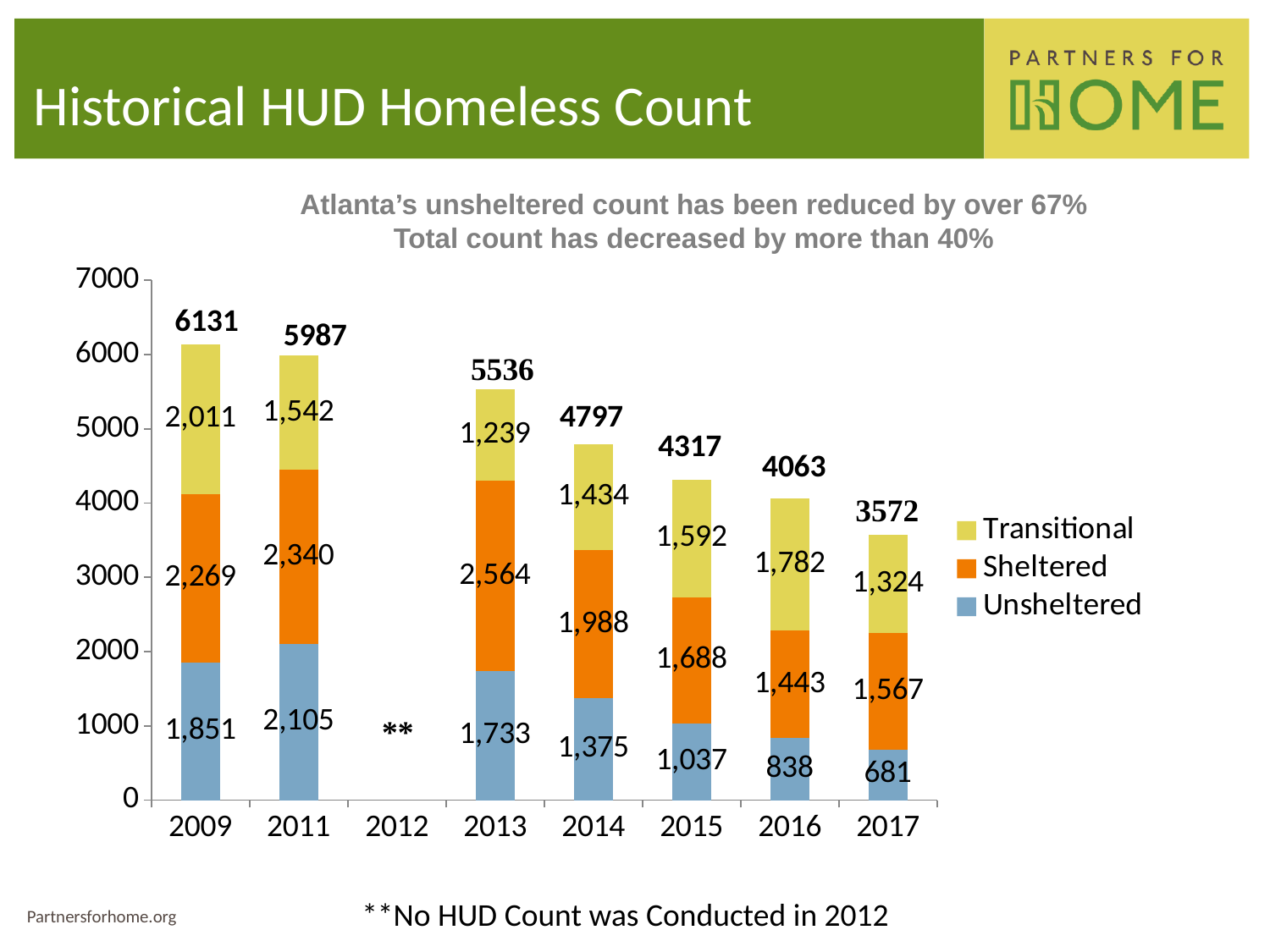
Which year on the x axis has no bar because no HUD count was conducted? 2012 What is the difference between the Unsheltered values for 2009 and 2017? 1,170 What is the Sheltered value for 2011? 2,340 Which year has the highest total homeless count? 2009 How many series does the legend list? 3 Which year has the lowest Unsheltered value? 2017 What kind of chart is shown on the slide? Stacked bar chart Do the total counts rise or fall from 2009 to 2017? Fall What is the Unsheltered value for 2009? 1,851 Which is larger in 2015, the Sheltered value or the Transitional value? Sheltered What is the total count shown above the 2017 bar? 3572 What is the Transitional value for 2016? 1,782